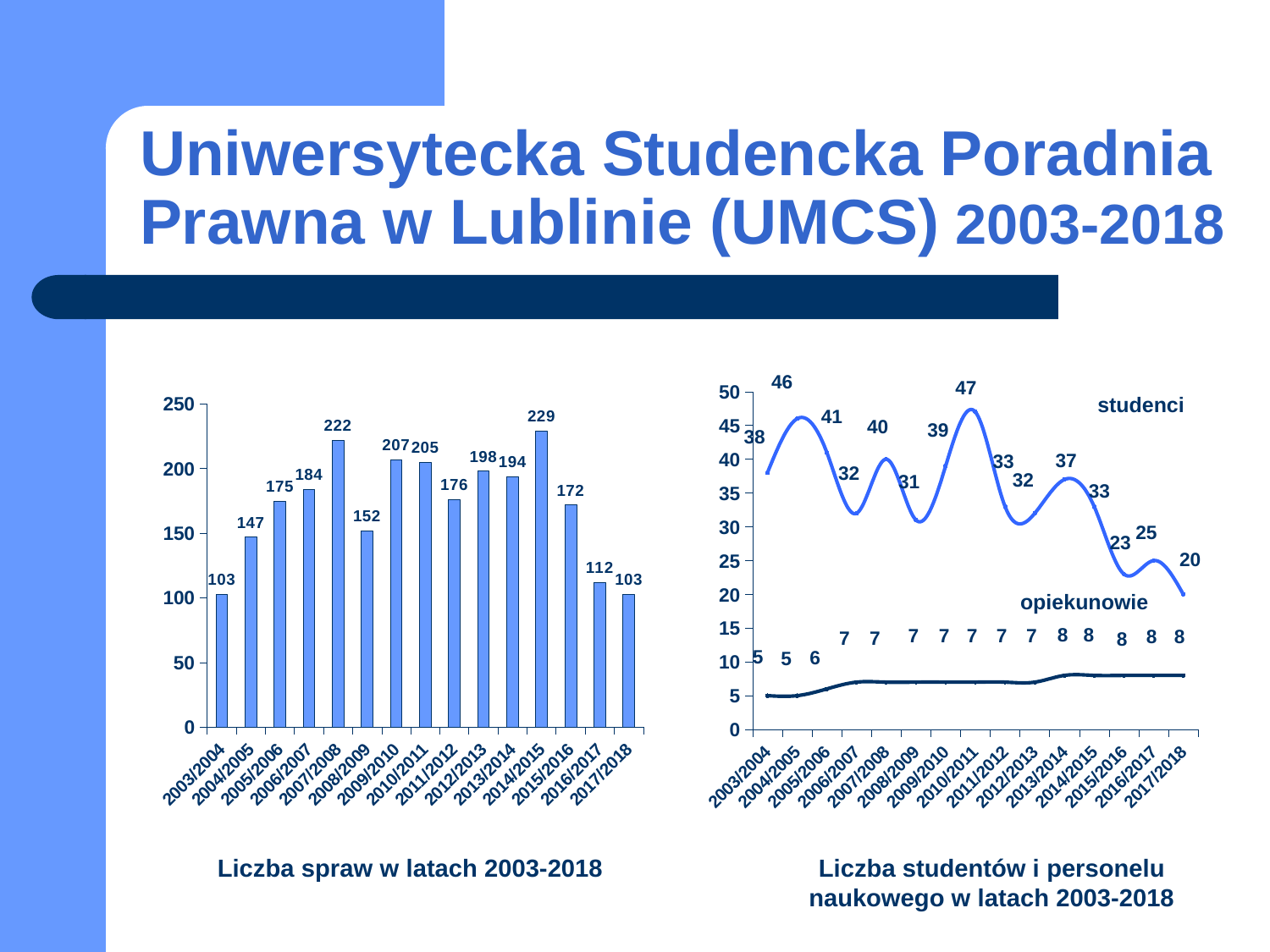
In the chart titled 'Liczba studentów i personelu naukowego w latach 2003-2018', what is the difference between the 'studenci' and 'opiekunowie' values for 2004/2005? 41 In the chart titled 'Liczba spraw w latach 2003-2018', what is the value for 2007/2008? 222 In the chart titled 'Liczba spraw w latach 2003-2018', what is the difference between the values for 2014/2015 and 2015/2016? 57 In the chart titled 'Liczba studentów i personelu naukowego w latach 2003-2018', what is the value of the 'opiekunowie' series for 2003/2004? 5 What kind of chart is the chart titled 'Liczba studentów i personelu naukowego w latach 2003-2018'? line chart What kind of chart is the chart titled 'Liczba spraw w latach 2003-2018'? bar chart How many categories are shown on the x axis of the chart titled 'Liczba spraw w latach 2003-2018'? 15 How many series are plotted in the chart titled 'Liczba studentów i personelu naukowego w latach 2003-2018'? 2 In the chart titled 'Liczba spraw w latach 2003-2018', which is larger, the value for 2009/2010 or the value for 2010/2011? 2009/2010 In the chart titled 'Liczba studentów i personelu naukowego w latach 2003-2018', what is the value of the 'studenci' series for 2010/2011? 47 In the chart titled 'Liczba studentów i personelu naukowego w latach 2003-2018', which year has the lowest value for the 'studenci' series? 2017/2018 In the chart titled 'Liczba spraw w latach 2003-2018', which year has the highest value? 2014/2015